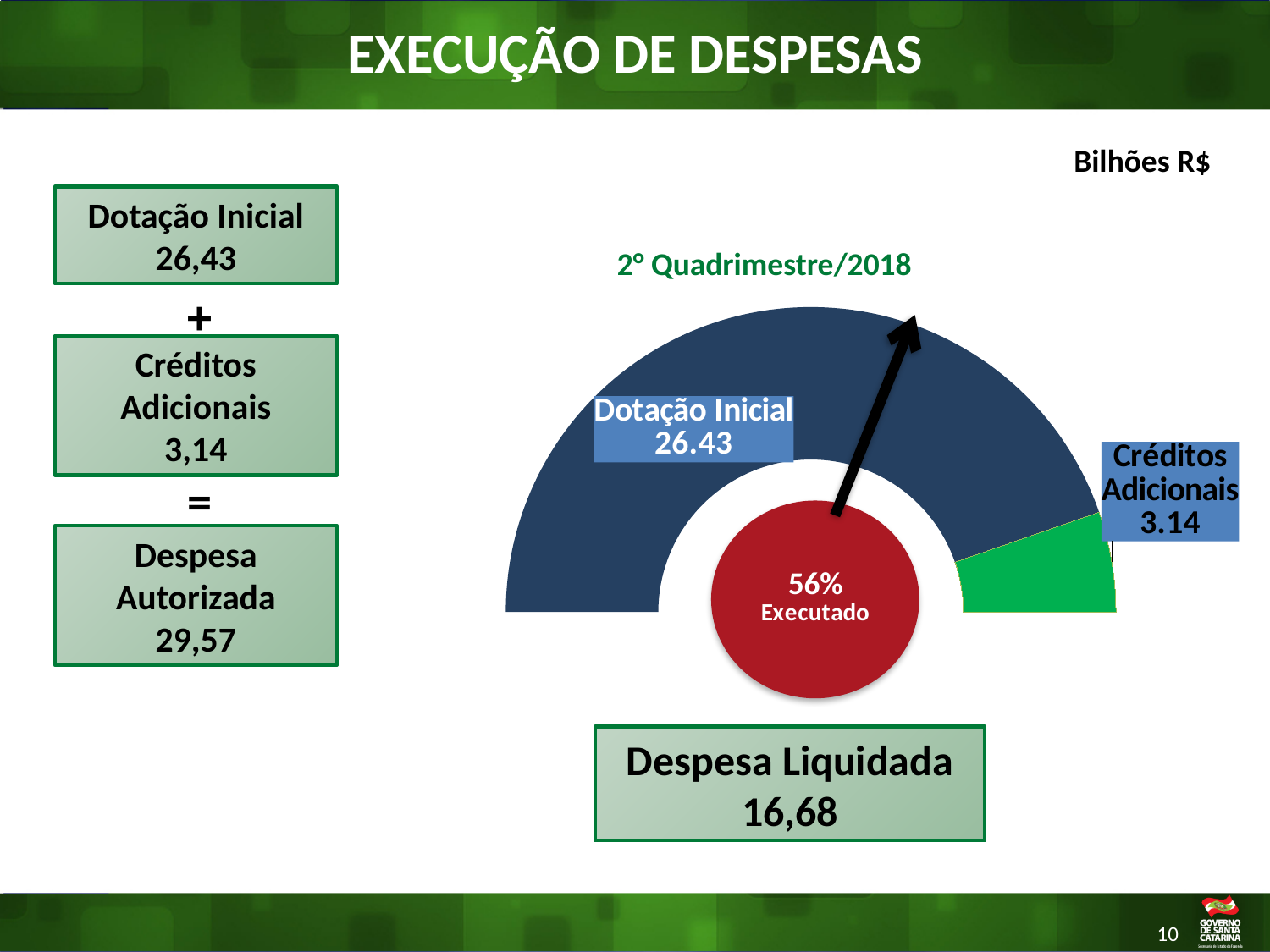
What is the total of the two segments shown on the chart (Dotação Inicial plus Créditos Adicionais)? 29.57 What percentage is shown in the centre of the gauge chart? 56% What is the value shown for Créditos Adicionais on the chart? 3.14 Which segment of the chart is larger, Dotação Inicial or Créditos Adicionais? Dotação Inicial What is the title shown above the chart? 2º Quadrimestre/2018 What is the value shown for Dotação Inicial on the chart? 26.43 Which segment of the chart has the smallest value? Créditos Adicionais What kind of chart is shown on the slide? gauge (semi-doughnut) chart How many segments does the gauge chart have? 2 What is the Despesa Liquidada value shown below the chart? 16,68 What is the difference between the Dotação Inicial value and the Créditos Adicionais value on the chart? 23.29 What colour is the Créditos Adicionais segment of the chart? green